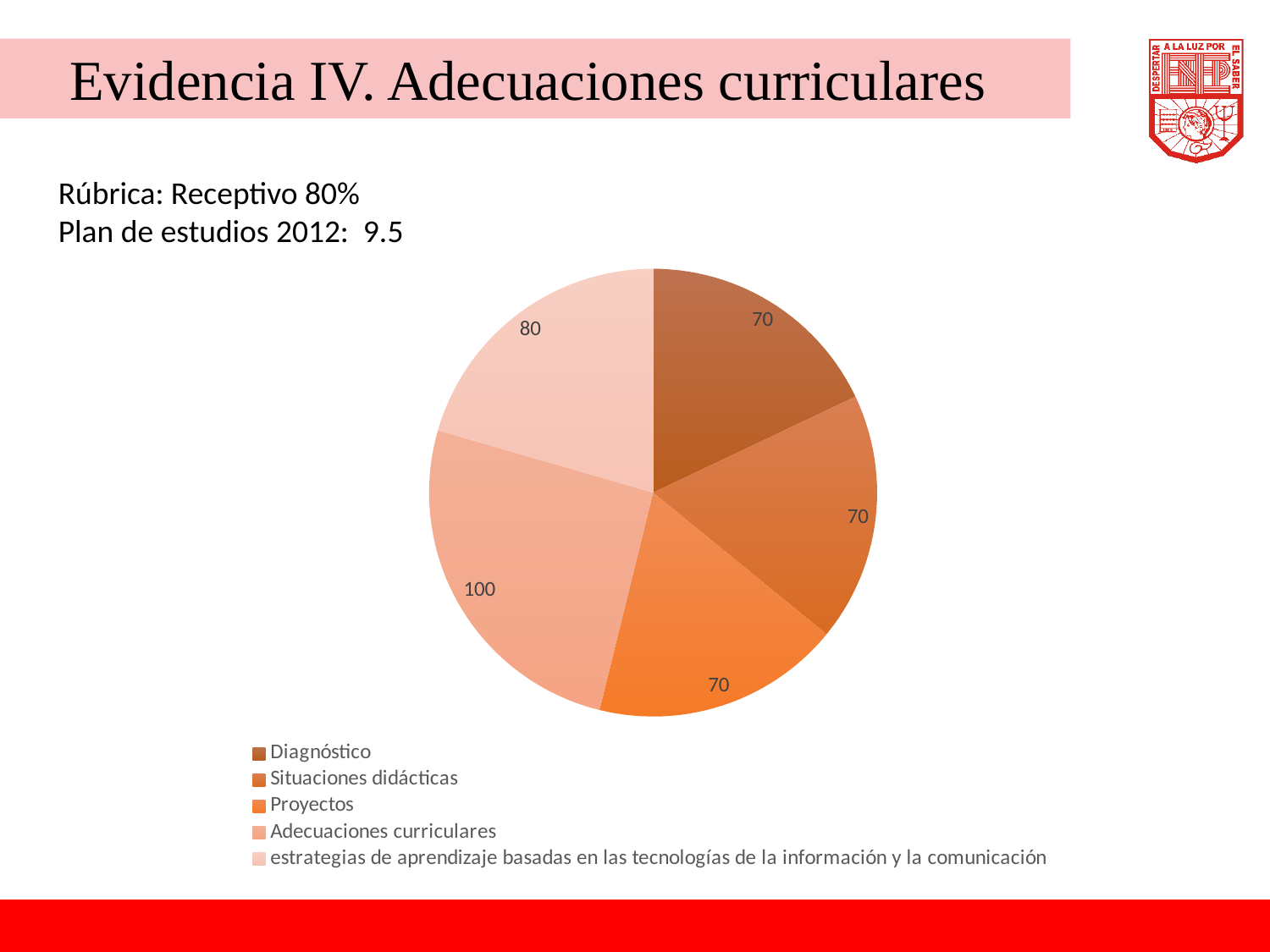
Which category has the largest slice in the pie chart? Adecuaciones curriculares What is the value for Diagnóstico in the pie chart? 70 What is the value for Adecuaciones curriculares in the pie chart? 100 Which is larger, the value for Adecuaciones curriculares or the value for estrategias de aprendizaje basadas en las tecnologías de la información y la comunicación? Adecuaciones curriculares What is the value for estrategias de aprendizaje basadas en las tecnologías de la información y la comunicación in the pie chart? 80 What type of chart is shown on the slide? pie chart What is the difference between the values for Adecuaciones curriculares and Situaciones didácticas? 30 What is the total of all the values shown in the pie chart? 390 What is the value for Proyectos in the pie chart? 70 How many slices in the pie chart have the value 70? 3 How many slices does the pie chart have? 5 How many entries does the legend of the pie chart list? 5